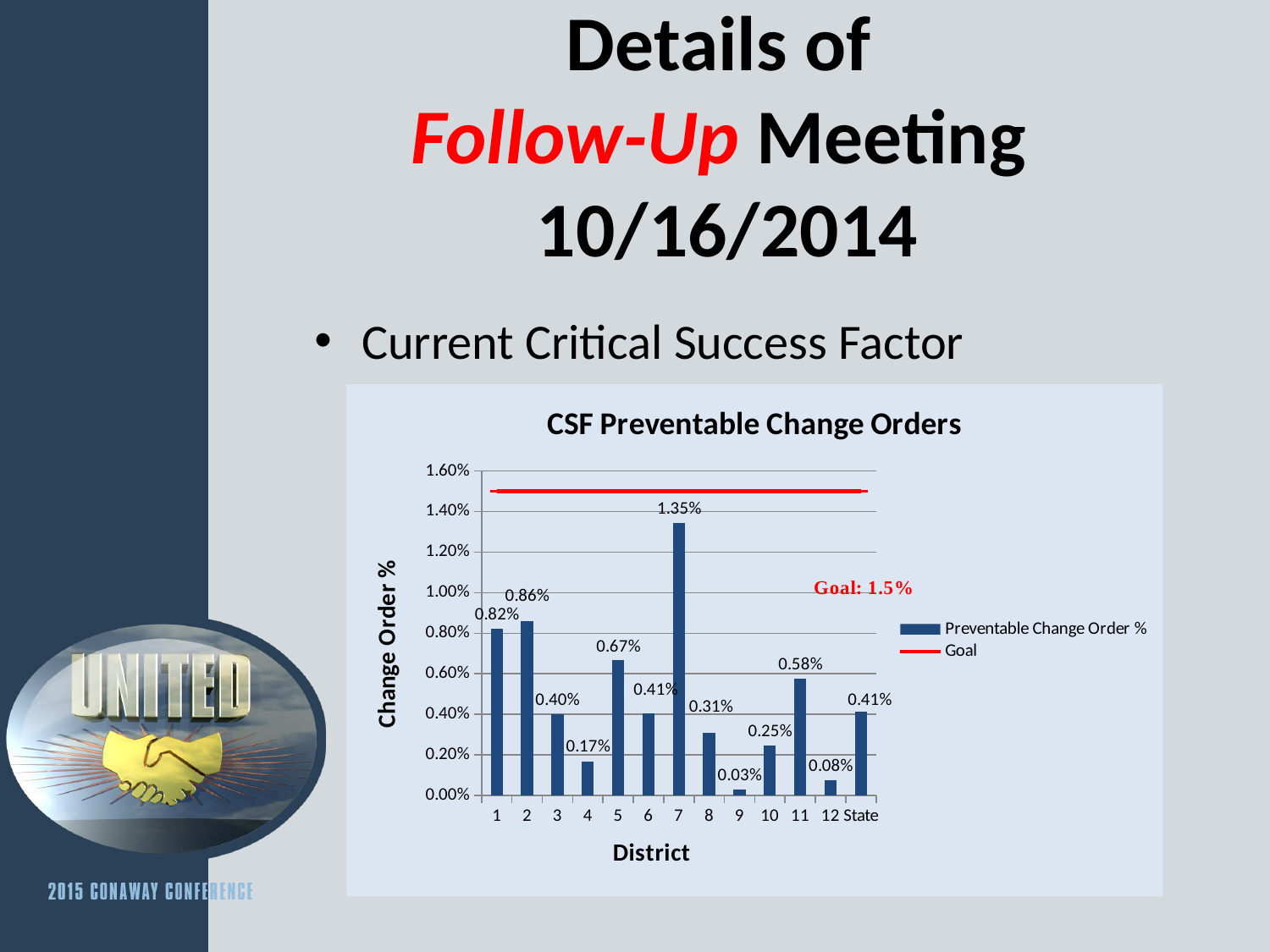
What is the Preventable Change Order % for the State? 0.41% Which district has the highest Preventable Change Order %? 7 Which district has the lowest Preventable Change Order %? 9 How many series does the chart legend list? 2 What is the difference between the Preventable Change Order % for District 2 and District 1? 0.04% What goal value is marked by the red line on the chart? 1.5% Which has a higher Preventable Change Order %, District 5 or District 3? District 5 Is the Preventable Change Order % for District 7 greater or less than 1.20%? greater What is the Preventable Change Order % for District 7? 1.35% How many categories are shown on the x axis of the chart? 13 What type of chart is used to show the Preventable Change Order % by district? bar chart What is the Preventable Change Order % for District 11? 0.58%